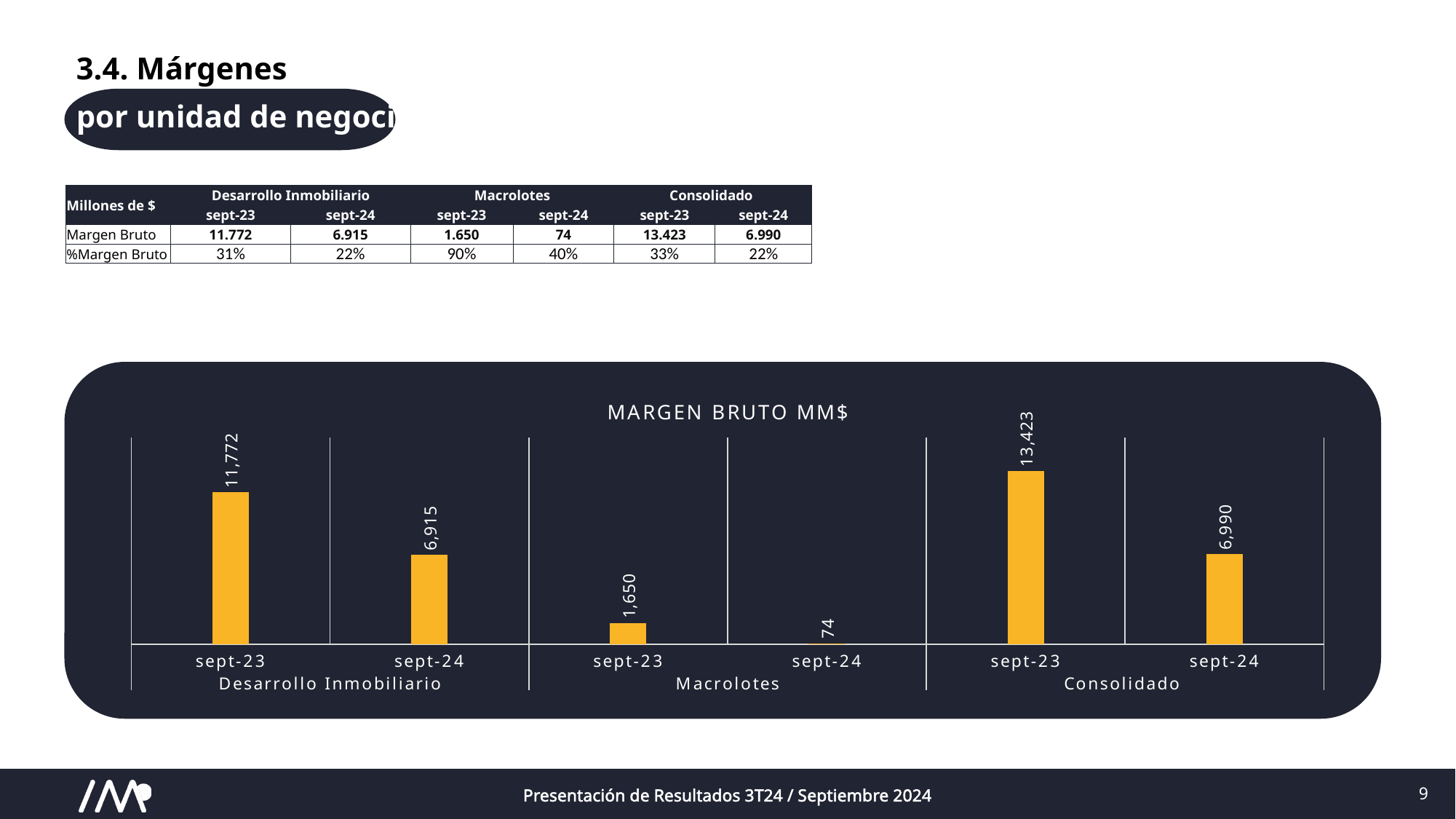
What kind of chart is the MARGEN BRUTO MM$ chart? Bar chart In the MARGEN BRUTO MM$ chart, what is the value for Desarrollo Inmobiliario in sept-23? 11,772 In the MARGEN BRUTO MM$ chart, what is the difference between Consolidado sept-23 and sept-24? 6,433 In the MARGEN BRUTO MM$ chart, what is the value for Consolidado in sept-24? 6,990 In the MARGEN BRUTO MM$ chart, what is the value for Macrolotes in sept-24? 74 In the MARGEN BRUTO MM$ chart, which is larger: Desarrollo Inmobiliario sept-24 or Consolidado sept-24? Consolidado sept-24 In the MARGEN BRUTO MM$ chart, which bar has the lowest value? Macrolotes sept-24 In the MARGEN BRUTO MM$ chart, which bar has the highest value? Consolidado sept-23 In the MARGEN BRUTO MM$ chart, what is the difference between Desarrollo Inmobiliario sept-23 and sept-24? 4,857 In the MARGEN BRUTO MM$ chart, what is the value for Macrolotes in sept-23? 1,650 How many bars are plotted in the MARGEN BRUTO MM$ chart? 6 In the MARGEN BRUTO MM$ chart, does the value for Macrolotes rise or fall from sept-23 to sept-24? Fall